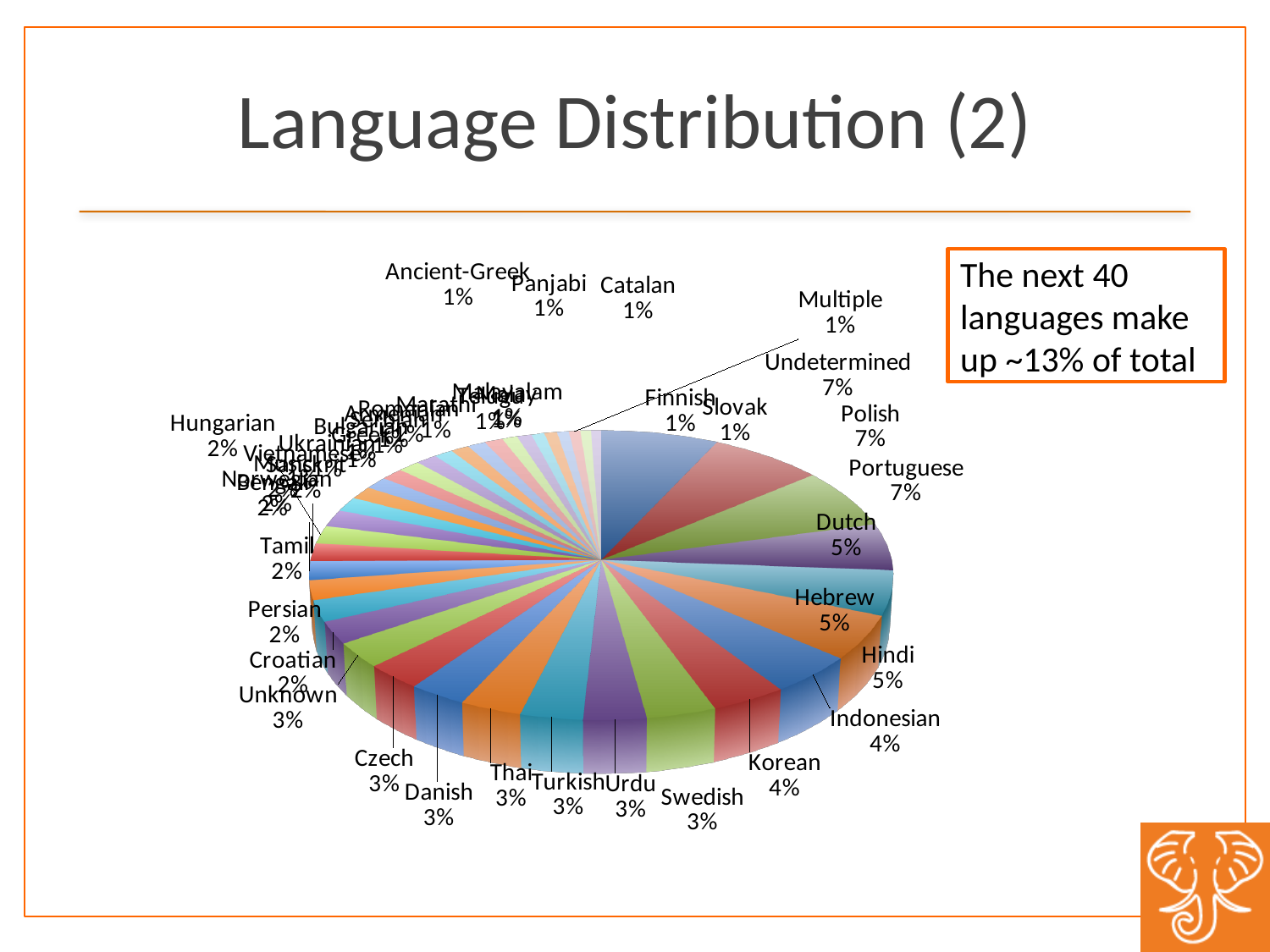
According to the text box next to the chart, roughly what share of the total do the next 40 languages make up? ~13% Which has the larger share, Korean or Persian? Korean Which has the larger share, Undetermined or Hindi? Undetermined What percentage is shown for Czech? 3% What type of chart is shown on the slide? pie chart What percentage is shown for Catalan? 1% What percentage is shown for Hungarian? 2% What share of the pie does Polish account for? 7% What percentage is shown for Indonesian? 4% What is the difference between the shares of Portuguese and Hebrew? 2% What is the title of the slide containing the pie chart? Language Distribution (2) What percentage is shown for Dutch? 5%